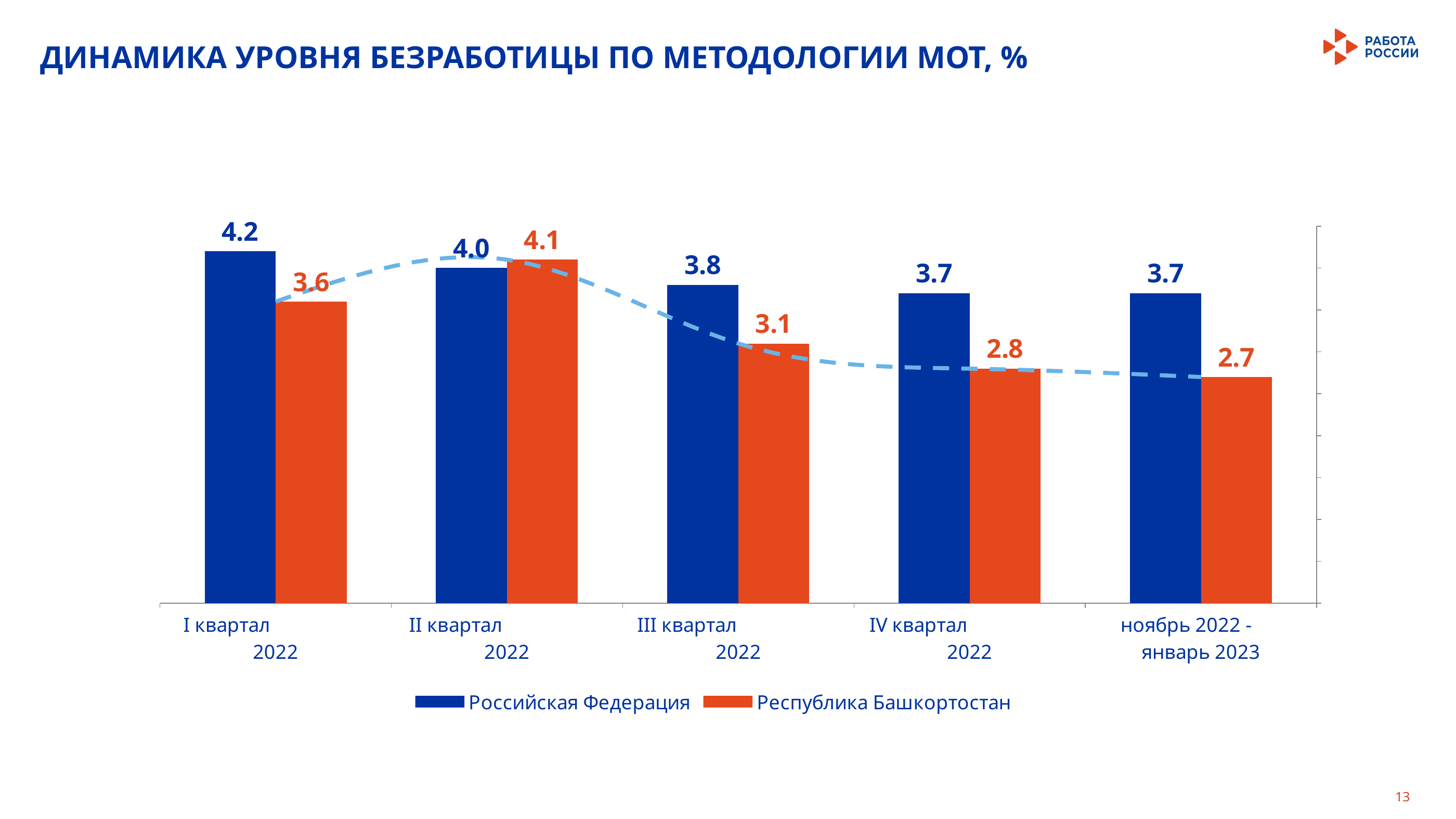
Which colour represents Российская Федерация in the chart? blue What is the value for Российская Федерация in I квартал 2022? 4.2 In which period is the value for Республика Башкортостан the highest? II квартал 2022 Do the values for Республика Башкортостан rise or fall from II квартал 2022 to ноябрь 2022 - январь 2023? fall How many periods are shown on the x axis? 5 Which is larger in II квартал 2022: Российская Федерация or Республика Башкортостан? Республика Башкортостан What is the difference between Российская Федерация and Республика Башкортостан in ноябрь 2022 - январь 2023? 1.0 What kind of chart is shown on the slide? combination bar and line chart What is the value for Республика Башкортостан in II квартал 2022? 4.1 In which period is the value for Республика Башкортостан the lowest? ноябрь 2022 - январь 2023 What is the value for Республика Башкортостан in ноябрь 2022 - январь 2023? 2.7 How many series does the legend list? 2